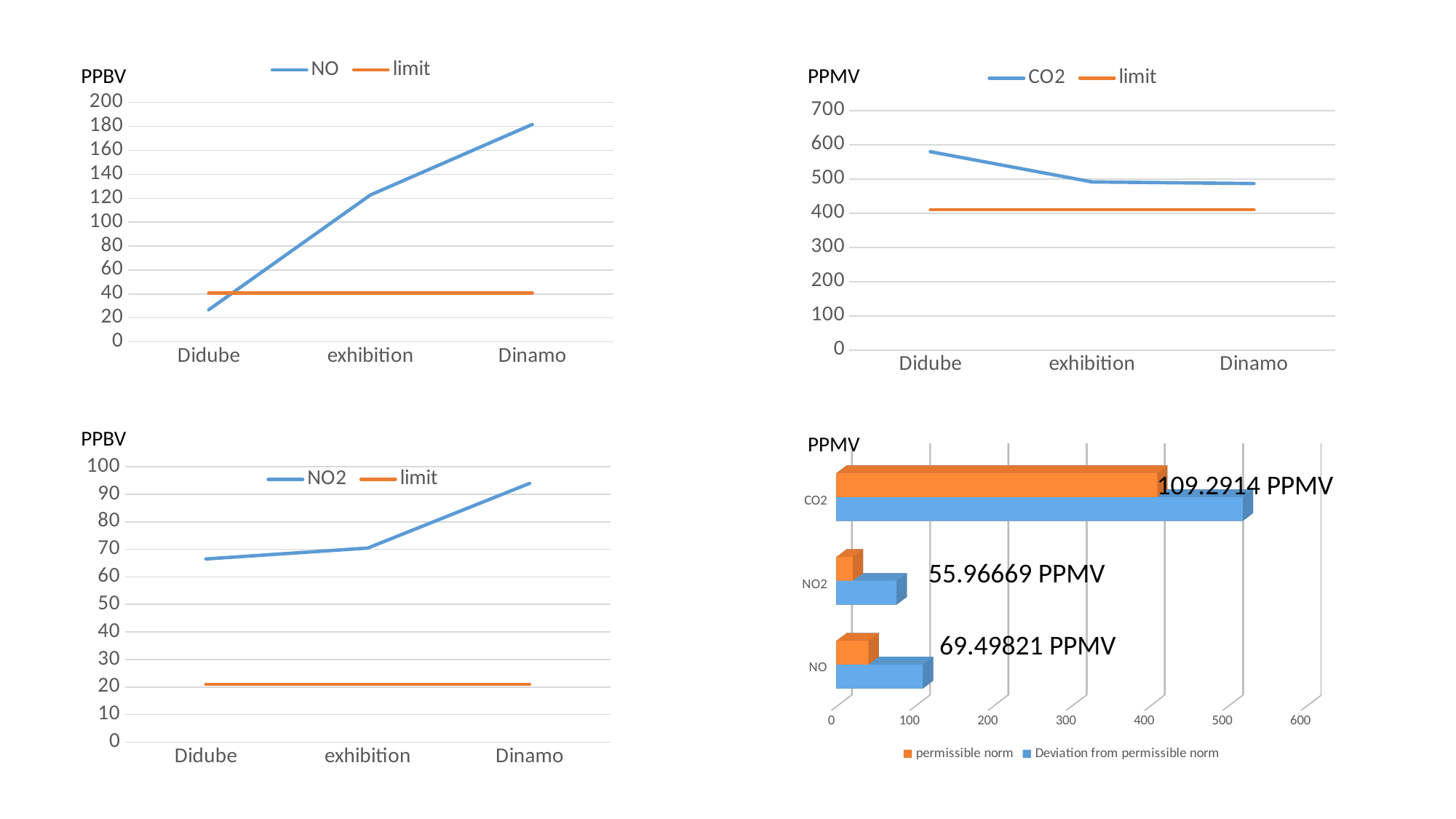
In the top-right chart (CO2, PPMV), at which location is the CO2 value highest? Didube In the top-left chart (NO, PPBV), at which location is the NO value highest? Dinamo In the top-left chart (NO, PPBV), does the NO line rise or fall from Didube to Dinamo? rises In the top-right chart (CO2, PPMV), does the CO2 line rise or fall from Didube to Dinamo? falls In the top-right chart (CO2, PPMV), is the limit value greater or less than 500? less What kind of chart is the bottom-right chart (PPMV, permissible norm)? bar chart How many series does the legend of the bottom-right chart (PPMV, permissible norm) list? 2 In the top-left chart (NO, PPBV), is the NO value at Didube greater or less than 40? less In the bottom-left chart (NO2, PPBV), is the NO2 value at Dinamo greater or less than 90? greater In the bottom-left chart (NO2, PPBV), at which location is the NO2 value lowest? Didube What kind of chart is the top-left chart (NO, PPBV)? line chart